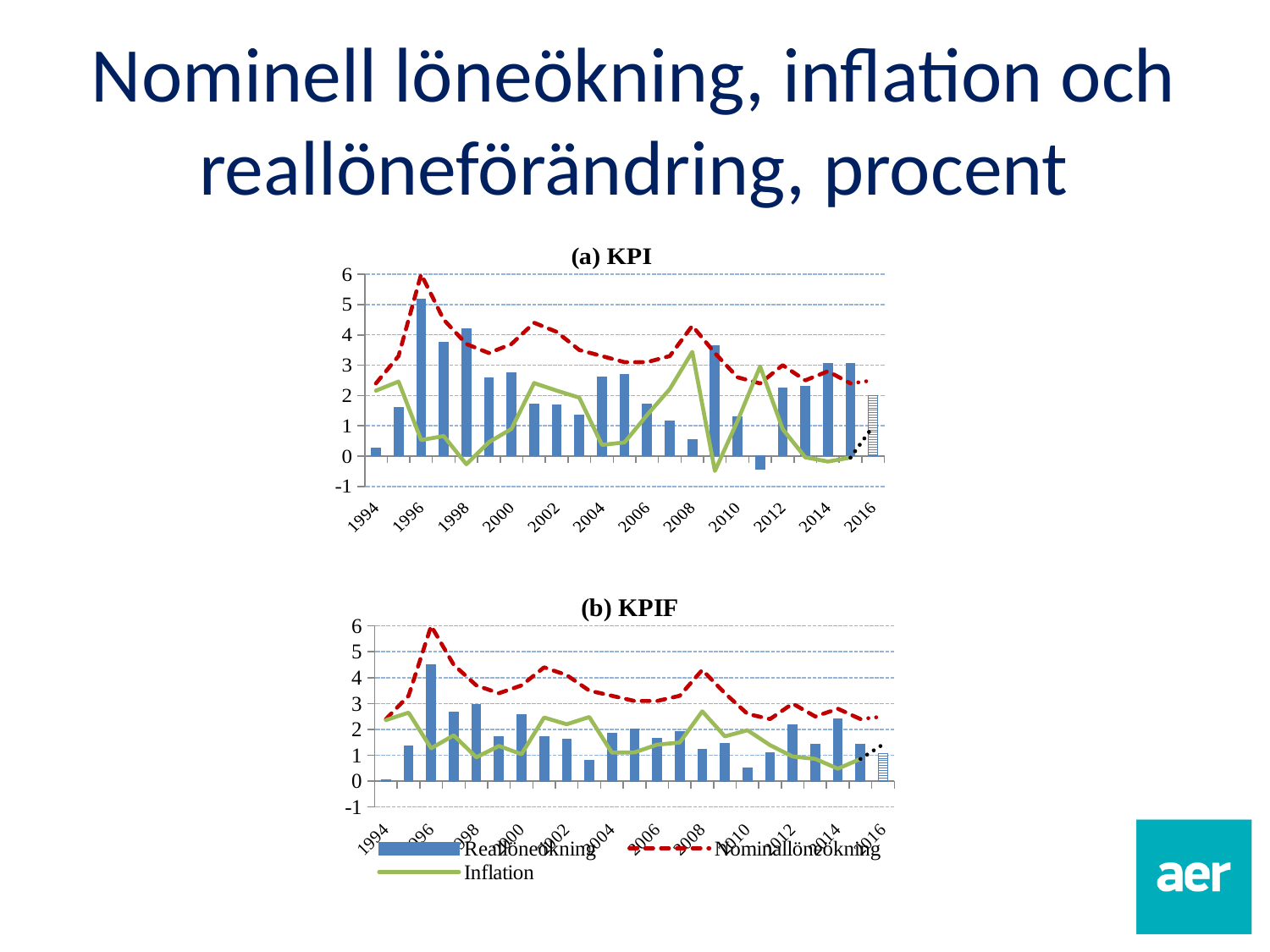
Which series is shown as a red dashed line in the legend? Nominallöneökning In the (a) KPI chart, is the Inflation value for 2009 greater or less than 0? less In the (a) KPI chart, which is larger, the Reallöneökning bar for 1996 or for 1997? 1996 What kind of chart is the (a) KPI chart? A bar chart combined with line series In the (b) KPIF chart, which is larger, the Reallöneökning bar for 2012 or for 2013? 2012 In the (a) KPI chart, is the Reallöneökning bar for 1996 greater or less than 4? greater In the (a) KPI chart, which year has the highest Reallöneökning bar? 1996 In the (b) KPIF chart, which year has the highest Reallöneökning bar? 1996 How many series does the legend list? 3 In the (a) KPI chart, which year has the lowest Reallöneökning bar? 2011 In the (a) KPI chart, does the Nominallöneökning line rise or fall from 1996 to 1998? fall